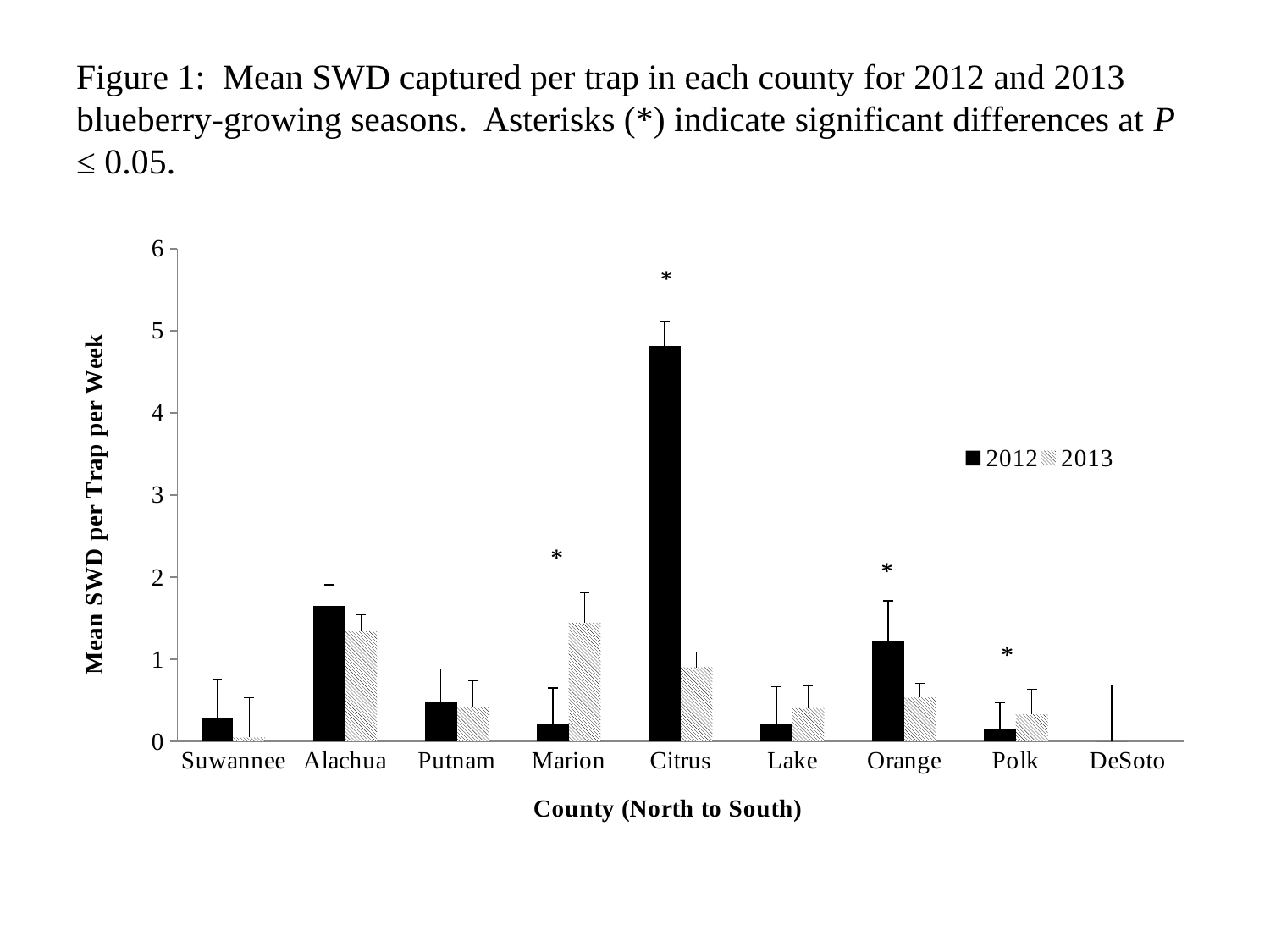
Is the 2012 value for Citrus greater or less than 4? greater For Marion, which year has the larger mean SWD per trap per week, 2012 or 2013? 2013 For Citrus, which year has the larger mean SWD per trap per week, 2012 or 2013? 2012 Is the 2013 value for Marion greater or less than 1? greater How many counties are shown on the x axis? 9 Which county has the highest mean SWD per trap per week for 2012? Citrus How many series does the legend list? 2 Is the 2012 value for Alachua greater or less than 2? less What is the title of the x axis? County (North to South) Which has the larger 2012 value, Alachua or Orange? Alachua What kind of chart is shown on the slide? Bar chart